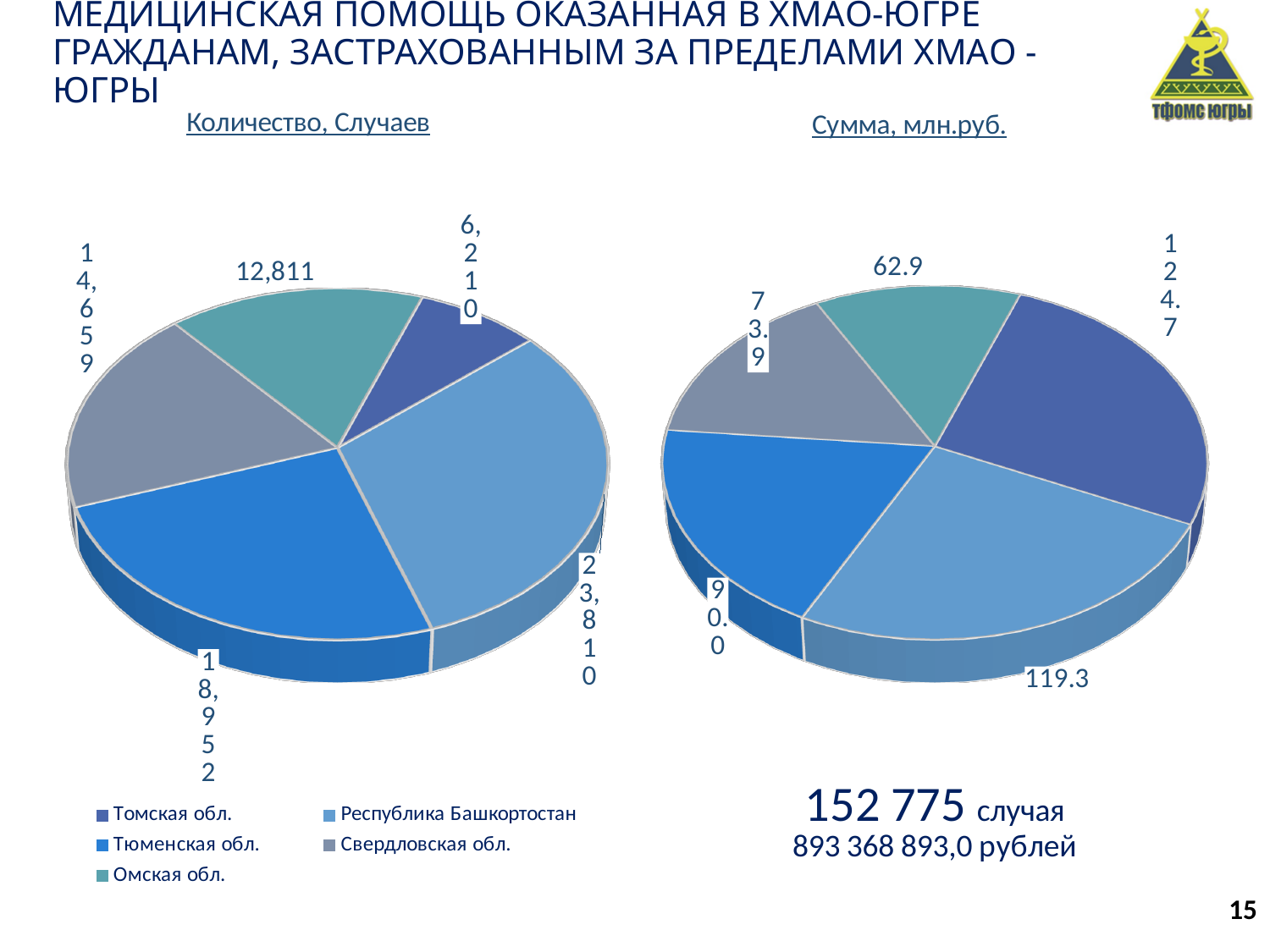
In the 'Количество, Случаев' pie chart, which region has the smallest slice? Томская обл. How many regions are shown in each pie chart? 5 In the 'Сумма, млн.руб.' pie chart, what is the value for Тюменская обл.? 90.0 In the 'Сумма, млн.руб.' pie chart, which is larger: Томская обл. or Тюменская обл.? Томская обл. In the 'Количество, Случаев' pie chart, what is the value for Томская обл.? 6,210 In the 'Сумма, млн.руб.' pie chart, which region has the smallest value? Омская обл. What type of chart is used on the left side of the slide? Pie chart In the 'Сумма, млн.руб.' pie chart, what is the value for Омская обл.? 62.9 In the 'Количество, Случаев' pie chart, which region has the largest slice? Республика Башкортостан In the 'Сумма, млн.руб.' pie chart, what is the difference between Томская обл. and Свердловская обл.? 50.8 In the 'Количество, Случаев' pie chart, what is the difference between Тюменская обл. and Омская обл.? 6,141 In the 'Количество, Случаев' pie chart, what is the value for Республика Башкортостан? 23,810